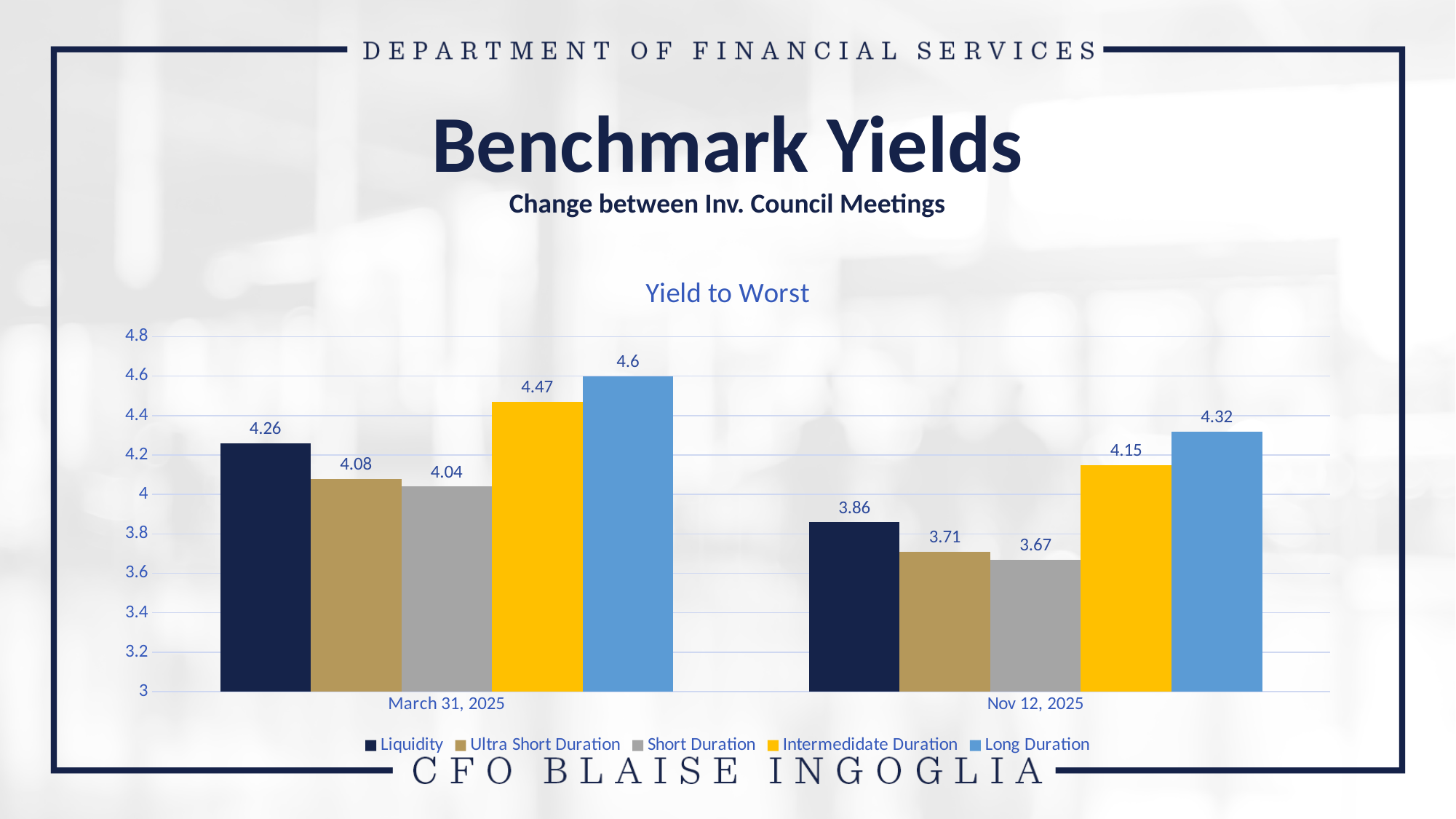
What is the Yield to Worst for Long Duration on March 31, 2025? 4.6 What is the difference between the Long Duration yield on March 31, 2025 and on Nov 12, 2025? 0.28 Which is larger: the Ultra Short Duration yield on March 31, 2025 or the Intermediate Duration yield on Nov 12, 2025? Intermediate Duration on Nov 12, 2025 What kind of chart is shown on the slide? Bar chart How many series does the legend list? 5 What is the Yield to Worst for Liquidity on Nov 12, 2025? 3.86 What is the title of the chart? Yield to Worst Do the Liquidity yields rise or fall from March 31, 2025 to Nov 12, 2025? Fall Which series has the highest Yield to Worst on March 31, 2025? Long Duration Which series has the lowest Yield to Worst on Nov 12, 2025? Short Duration What is the Yield to Worst for Intermediate Duration on Nov 12, 2025? 4.15 How many date categories are shown on the x axis? 2